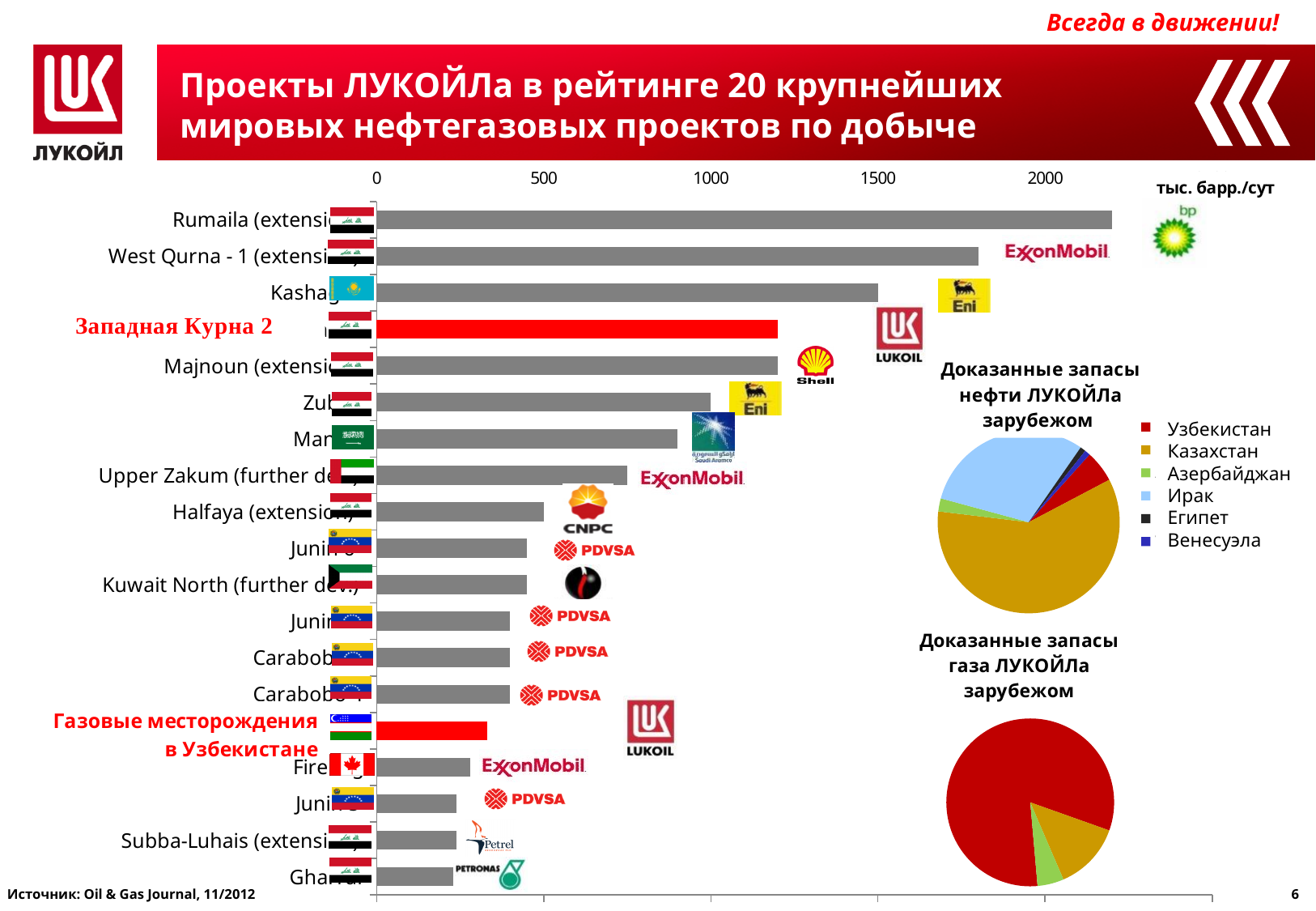
In the bar chart, is the value for Западная Курна 2 greater or less than 1000? greater In the bar chart, is the value for Upper Zakum (further dev.) greater or less than 1000? less What kind of charts are the two charts on the right of the slide (Доказанные запасы нефти/газа ЛУКОЙЛа зарубежом)? pie charts In the bar chart, is the value for West Qurna - 1 (extension) greater or less than 1500? greater In the bar chart, which is larger: Rumaila (extension) or West Qurna - 1 (extension)? Rumaila (extension) In the pie chart Доказанные запасы нефти ЛУКОЙЛа зарубежом, which country has the largest share? Казахстан In the pie chart Доказанные запасы газа ЛУКОЙЛа зарубежом, which country has the largest share? Узбекистан In the bar chart of the 20 largest projects, which project has the highest value? Rumaila (extension) In the bar chart, which is larger: Kashagan or Majnoun (extension)? Kashagan What kind of chart is the large chart on the left of the slide? bar chart